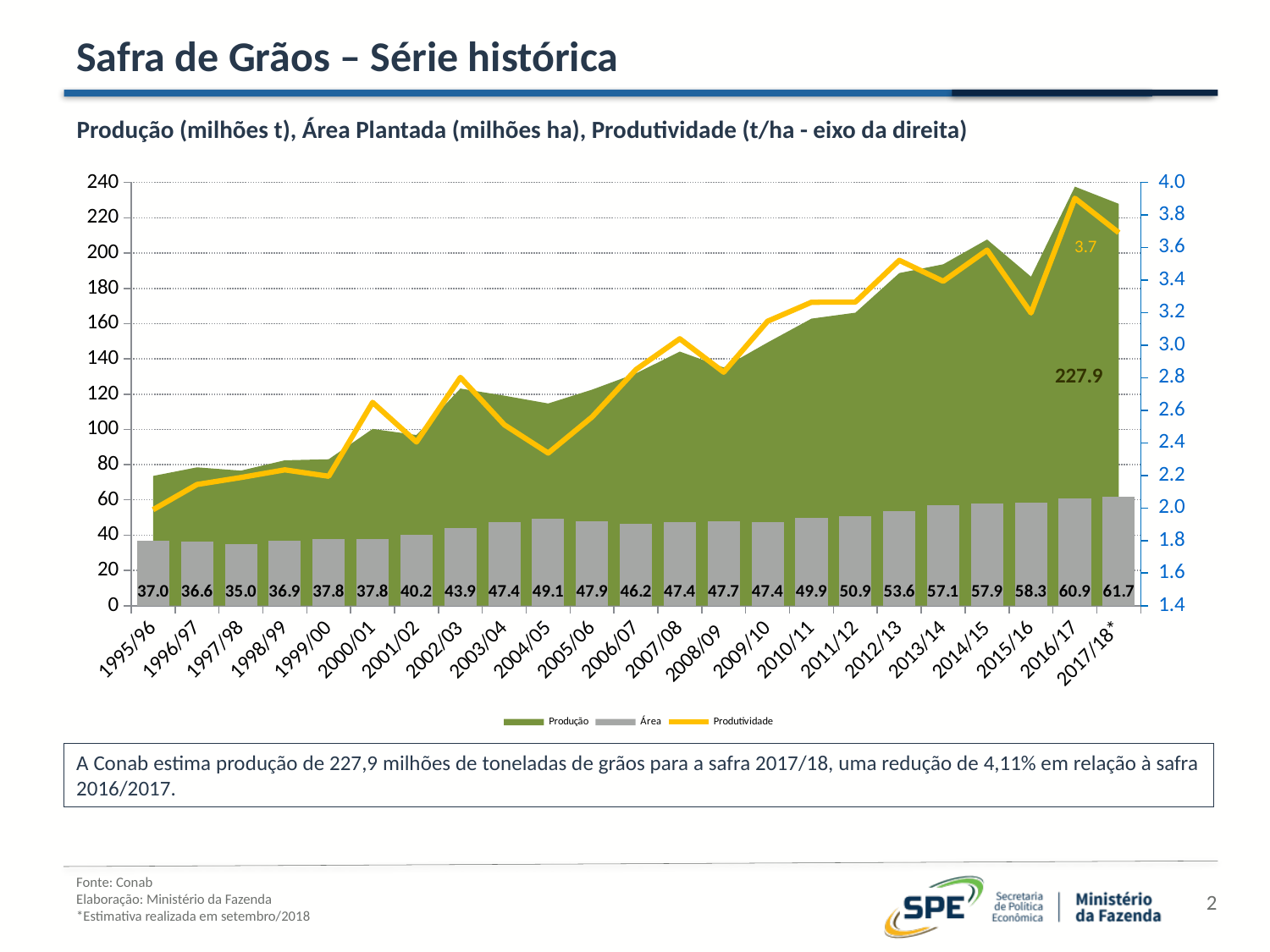
Which season has the lowest Área value? 1997/98 Which has the larger Área value, 2004/05 or 2005/06? 2004/05 What is the Produtividade value labelled for 2017/18*? 3.7 How many series does the legend list? 3 What is the value of Área for 2017/18*? 61.7 What is the value of Área for 1995/96? 37.0 Which season has the highest Área value? 2017/18* How many seasons are shown on the x axis? 23 What is the difference between the Área values for 2017/18* and 1995/96? 24.7 Is the Produção value for 2016/17 greater or less than 220? greater Does the Área series generally rise or fall from 1995/96 to 2017/18*? rise What is the Produção value labelled for 2017/18*? 227.9